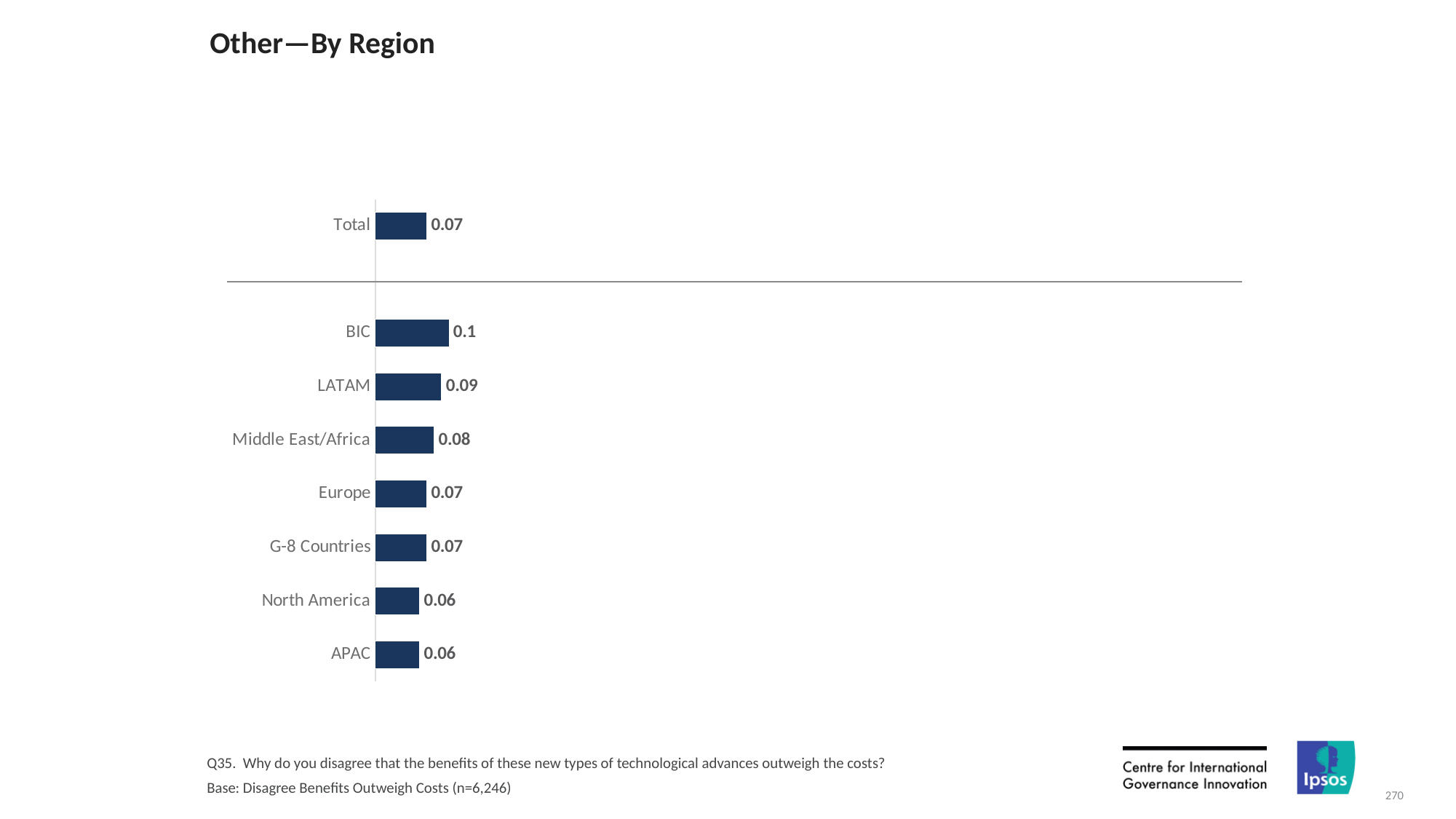
Which is larger, the value for Middle East/Africa or the value for G-8 Countries? Middle East/Africa What kind of chart is shown on the slide? Bar chart What is the value for Middle East/Africa? 0.08 What is the value for North America? 0.06 What is the difference between the values for LATAM and Europe? 0.02 What is the difference between the values for BIC and APAC? 0.04 What is the value for BIC? 0.1 What is the value for LATAM? 0.09 How many bars are plotted on the chart, including Total? 8 What is the title of the chart? Other—By Region Which region has the highest value? BIC What is the value for Total? 0.07